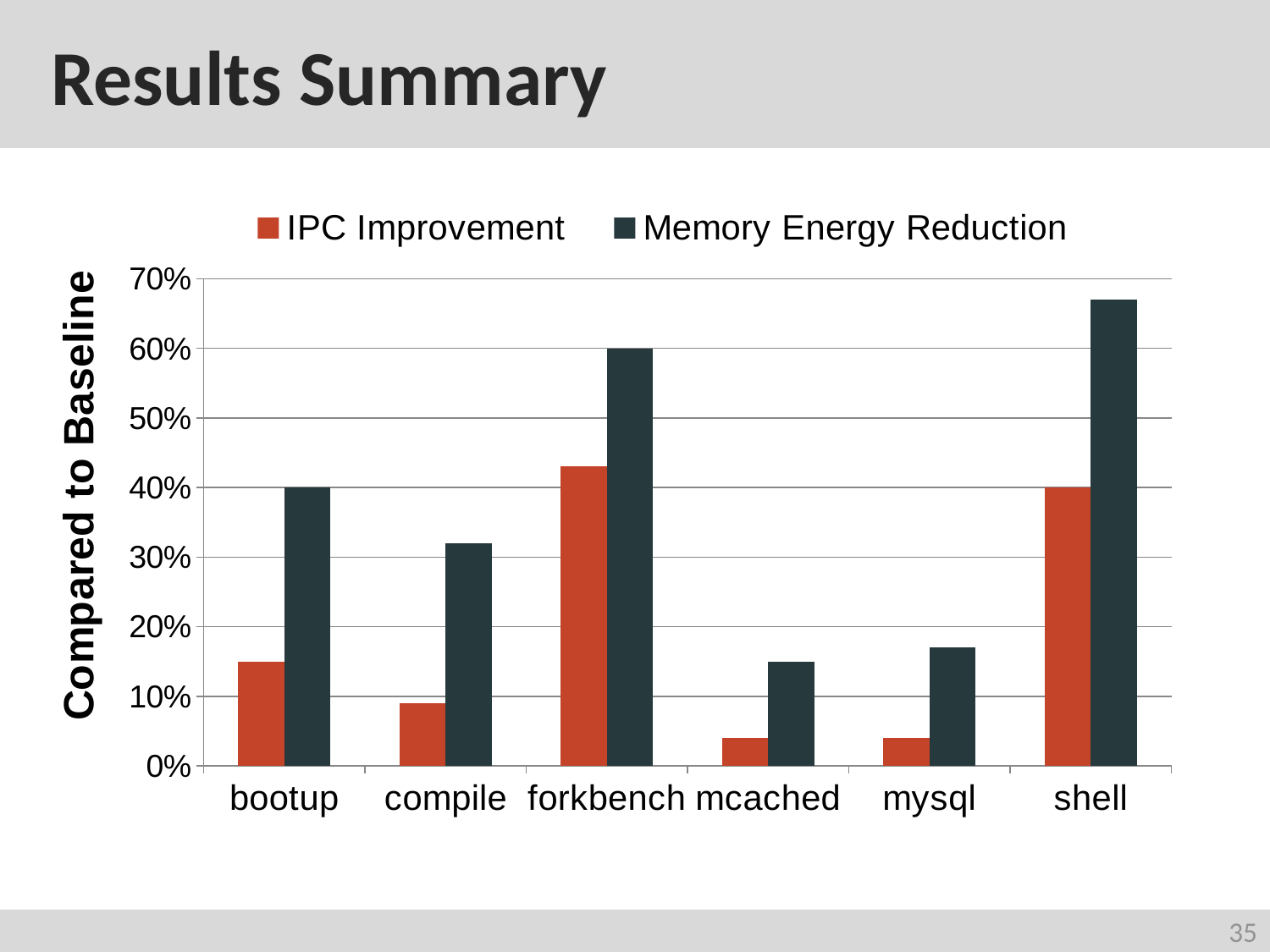
What is the Memory Energy Reduction for bootup? 40% Which category has the highest IPC Improvement? forkbench Which is larger for compile: IPC Improvement or Memory Energy Reduction? Memory Energy Reduction How many categories are shown on the x axis? 6 Which category has the lowest Memory Energy Reduction? mcached What is the title of the y axis? Compared to Baseline Is the IPC Improvement for compile greater or less than 10%? less Which category has the highest Memory Energy Reduction? shell What is the Memory Energy Reduction for forkbench? 60% How many series does the legend list? 2 Is the Memory Energy Reduction for shell greater or less than 60%? greater What kind of chart is shown on the slide? bar chart